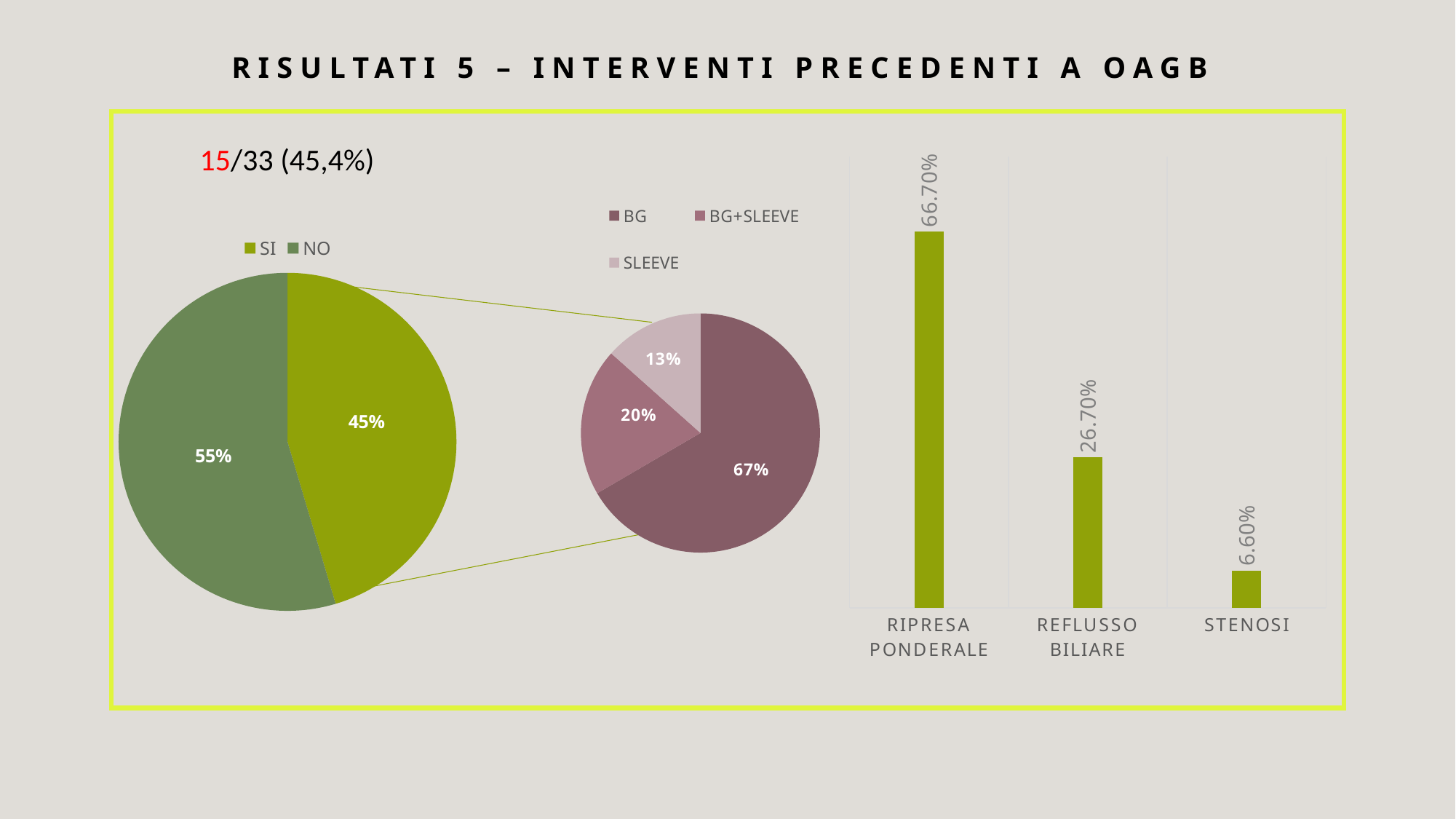
In the middle pie chart, how many categories does the legend list? 3 In the left pie chart (SI/NO), what share does the NO slice have? 55% In the left pie chart (SI/NO), what share does the SI slice have? 45% In the bar chart on the right, what is the difference between RIPRESA PONDERALE and STENOSI? 60.10% In the bar chart on the right, what is the value for RIFLUSSO BILIARE? 26.70% In the bar chart on the right, which category has the lowest value? STENOSI What kind of chart is the chart on the right of the slide? Bar chart In the middle pie chart (BG / BG+SLEEVE / SLEEVE), which category has the smallest slice? SLEEVE In the middle pie chart (BG / BG+SLEEVE / SLEEVE), what share does the SLEEVE slice have? 13% In the middle pie chart (BG / BG+SLEEVE / SLEEVE), what is the difference between the BG and BG+SLEEVE shares? 47% In the left pie chart (SI/NO), which slice is larger, SI or NO? NO In the middle pie chart (BG / BG+SLEEVE / SLEEVE), what share does the BG slice have? 67%